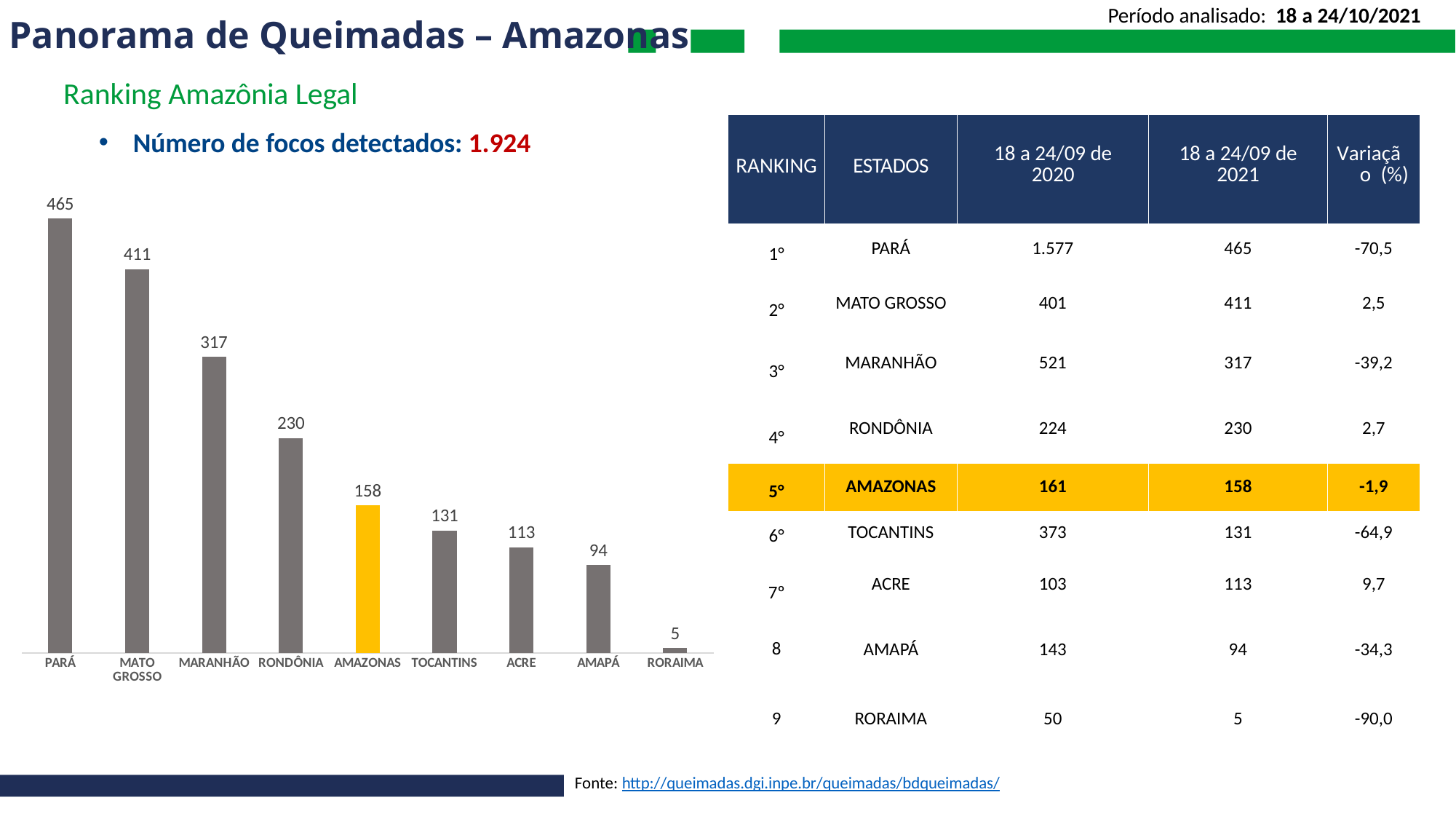
What is the value shown for AMAZONAS in the bar chart? 158 How many states are shown in the bar chart? 9 Which is larger in the bar chart, the value for RONDÔNIA or the value for MARANHÃO? MARANHÃO Which bar in the chart is highlighted in yellow rather than grey? AMAZONAS What is the difference between the values for AMAZONAS and ACRE in the bar chart? 45 What is the value shown for TOCANTINS in the bar chart? 131 Do the bar values rise or fall from left to right across the chart? fall Which state has the highest bar in the chart? PARÁ What kind of chart is shown on the slide? bar chart What is the difference between the values for PARÁ and MATO GROSSO in the bar chart? 54 Which state has the lowest bar in the chart? RORAIMA What is the value shown for PARÁ in the bar chart? 465